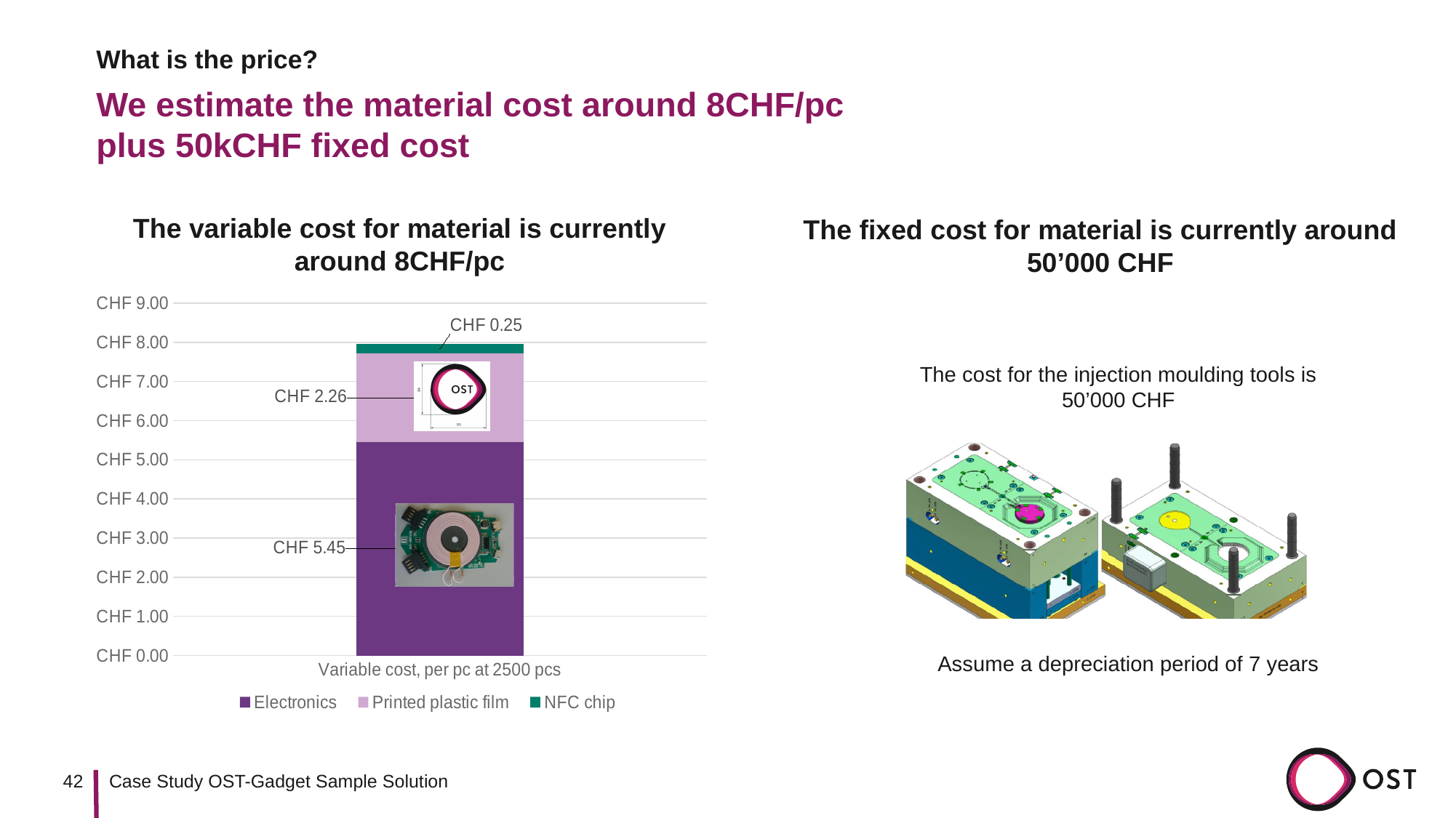
What is the title of the chart? The variable cost for material is currently around 8CHF/pc What kind of chart is shown on the slide? Stacked bar chart How many series does the legend list? 3 What is the difference between the Electronics and Printed plastic film values? CHF 3.19 Which is larger, the Printed plastic film value or the NFC chip value? Printed plastic film What is the value of the Electronics segment in the stacked bar? CHF 5.45 Which series contributes the largest amount to the variable cost bar? Electronics Which series contributes the smallest amount to the variable cost bar? NFC chip What is the value of the Printed plastic film segment in the stacked bar? CHF 2.26 What is the value of the NFC chip segment in the stacked bar? CHF 0.25 How many categories are shown on the x axis of the chart? 1 What is the total of the stacked bar for 'Variable cost, per pc at 2500 pcs'? CHF 7.96